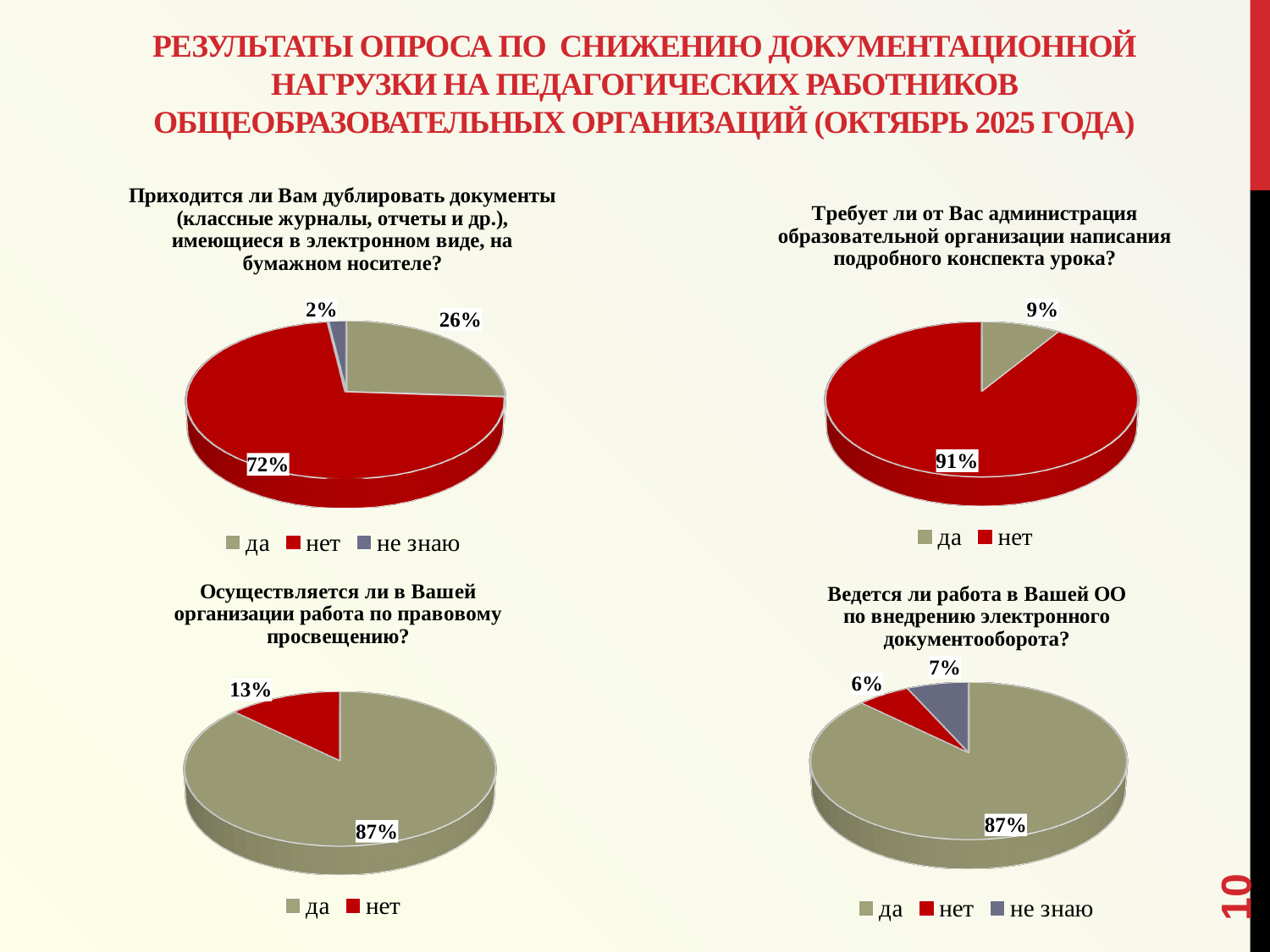
What type of chart is used for the top-right chart (about the administration requiring a detailed lesson plan)? Pie chart On the bottom-left pie chart (about legal education work in the organization), which answer is larger, "да" or "нет"? да On the top-right pie chart (about the administration requiring a detailed lesson plan), what is the difference between the "нет" and "да" shares? 82% On the top-left pie chart (about duplicating electronic documents on paper), what share of respondents answered "нет"? 72% On the top-right pie chart (about the administration requiring a detailed lesson plan), what share answered "нет"? 91% On the top-left pie chart (about duplicating electronic documents on paper), what share of respondents answered "да"? 26% On the bottom-right pie chart (about implementing electronic document flow), what share answered "не знаю"? 7% How many pie charts are shown on the slide? 4 On the top-left pie chart (about duplicating electronic documents on paper), which answer has the smallest share? не знаю On the bottom-left pie chart (about legal education work in the organization), what share answered "да"? 87% How many entries does the legend of the bottom-right pie chart (about implementing electronic document flow) list? 3 On the bottom-right pie chart (about implementing electronic document flow), which answer has the largest share? да